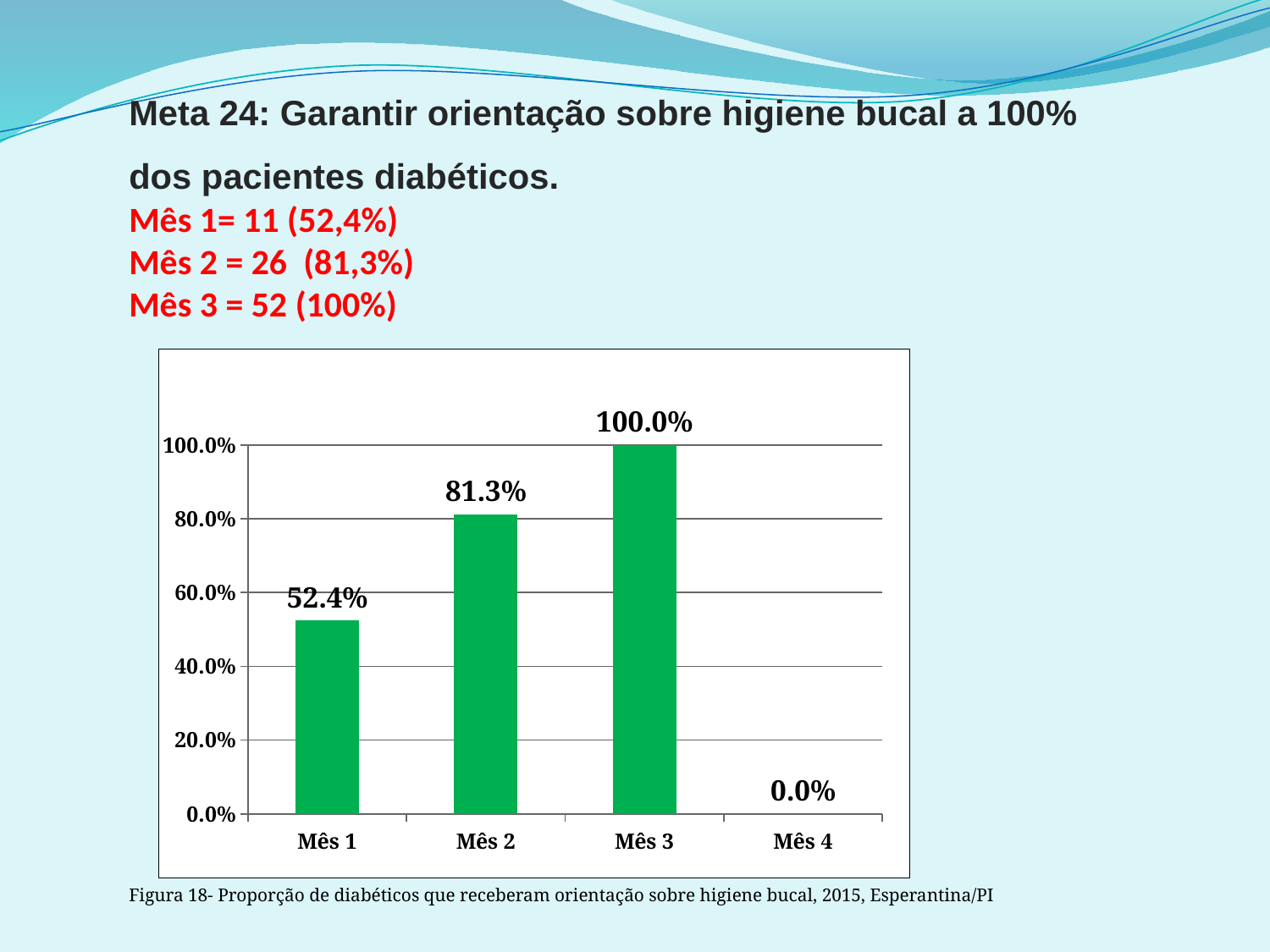
What is the value for Mês 4? 0.0% Do the values rise or fall from Mês 1 to Mês 3? rise What is the difference between the values for Mês 3 and Mês 1? 47.6% What kind of chart is shown on the slide? bar chart Which is larger, the value for Mês 1 or the value for Mês 2? Mês 2 What is the value for Mês 2? 81.3% What is the value for Mês 1? 52.4% Which category has the highest value? Mês 3 Which category has the lowest value? Mês 4 What is the difference between the values for Mês 2 and Mês 1? 28.9% Is the value for Mês 1 greater or less than 60.0%? less How many categories are shown on the x axis? 4